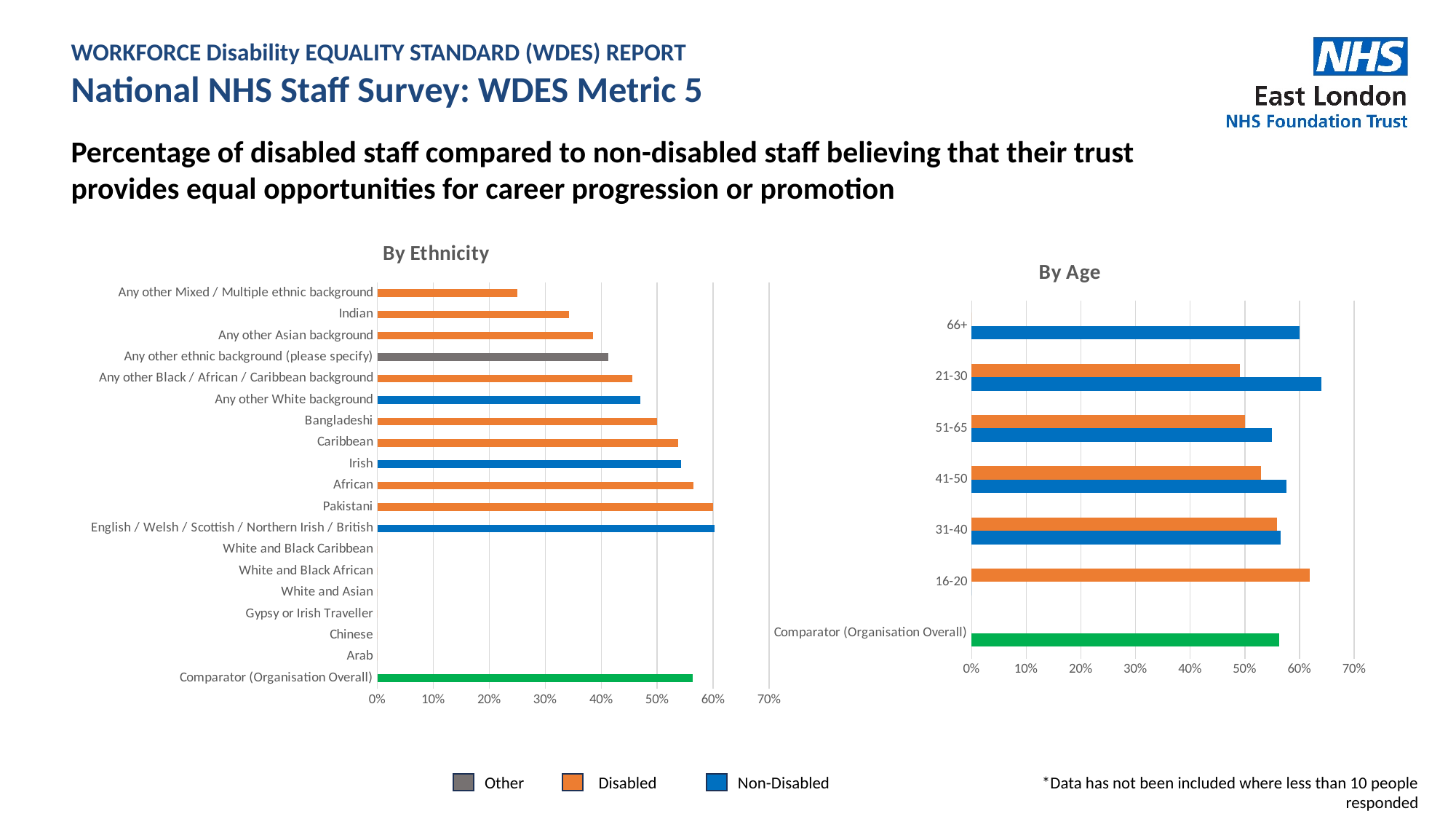
In the 'By Age' chart, which age group has the highest Disabled value? 16-20 What kind of chart is the 'By Ethnicity' chart? bar chart In the 'By Ethnicity' chart, is the value for 'Indian' greater or less than 30%? greater In the 'By Age' chart, which age group has the highest Non-Disabled value? 21-30 In the 'By Ethnicity' chart, is the value for 'Any other White background' greater or less than 50%? less In the 'By Age' chart, which colour represents the Comparator (Organisation Overall) bar? green In the 'By Ethnicity' chart, is the value for 'Any other Mixed / Multiple ethnic background' greater or less than 30%? less In the 'By Ethnicity' chart, how many listed categories have no bar plotted? 6 In the 'By Age' chart, for the 21-30 group, which is larger: the Disabled value or the Non-Disabled value? Non-Disabled In the 'By Ethnicity' chart, which category with a plotted bar has the lowest value? Any other Mixed / Multiple ethnic background How many series does the legend list? 3